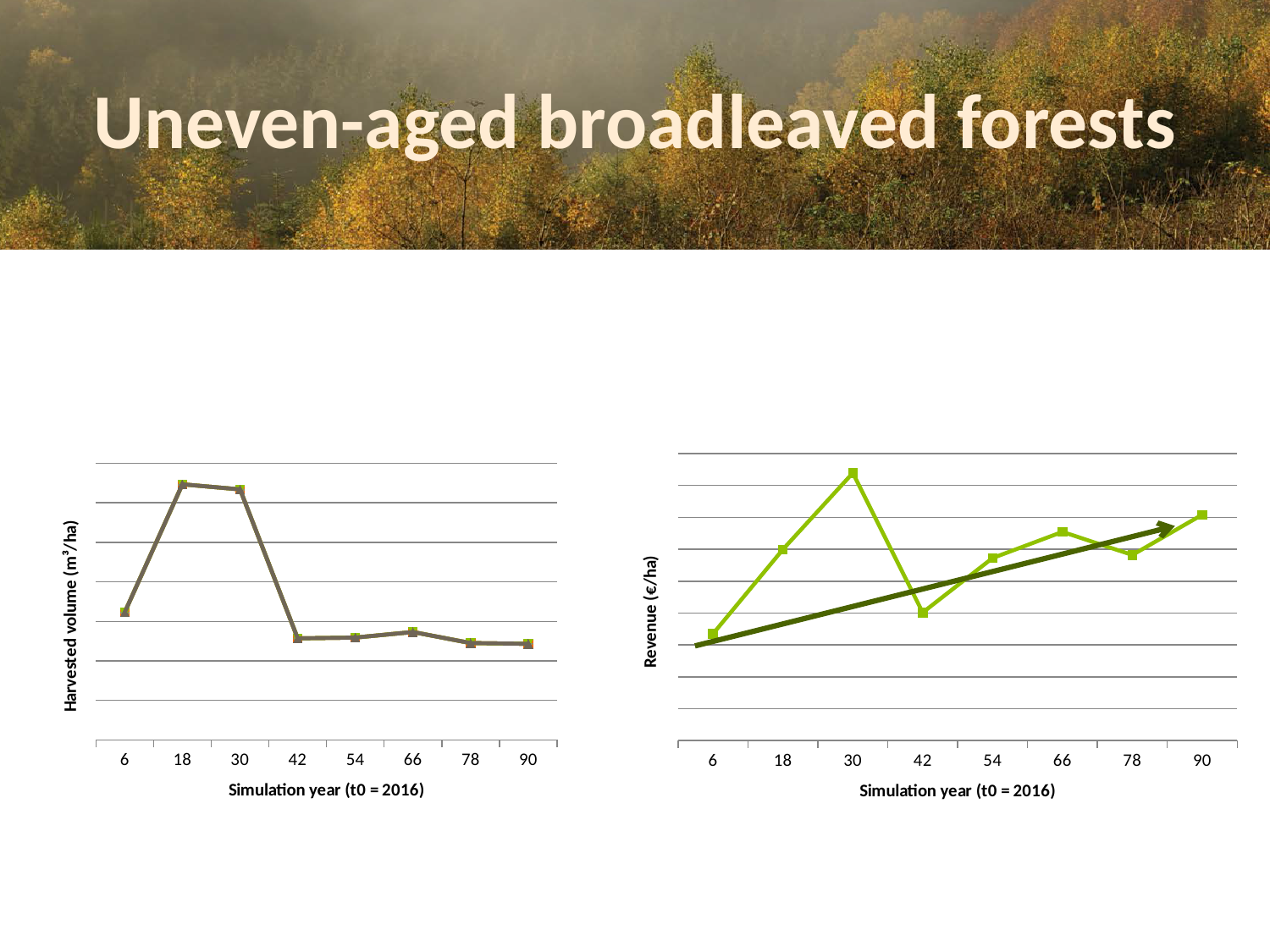
What kind of chart is the right chart (Revenue)? line chart In the right chart (Revenue), is revenue larger at year 30 or at year 42? 30 In the left chart (Harvested volume), is the harvested volume larger at year 6 or at year 54? 6 What kind of chart is the left chart (Harvested volume)? line chart In the right chart (Revenue), at which simulation year is revenue highest? 30 In the right chart (Revenue), at which simulation year is revenue lowest? 6 In the right chart (Revenue), how many data points are plotted on the line? 8 In the left chart, what is the label of the y axis? Harvested volume (m³/ha) In the left chart (Harvested volume), how many simulation years are plotted along the x axis? 8 In the right chart (Revenue), does the straight arrow indicate an overall rising or falling trend in revenue over the simulation years? rising In the right chart, what is the label of the x axis? Simulation year (t0 = 2016) In the left chart (Harvested volume), is the harvested volume larger at year 18 or at year 42? 18